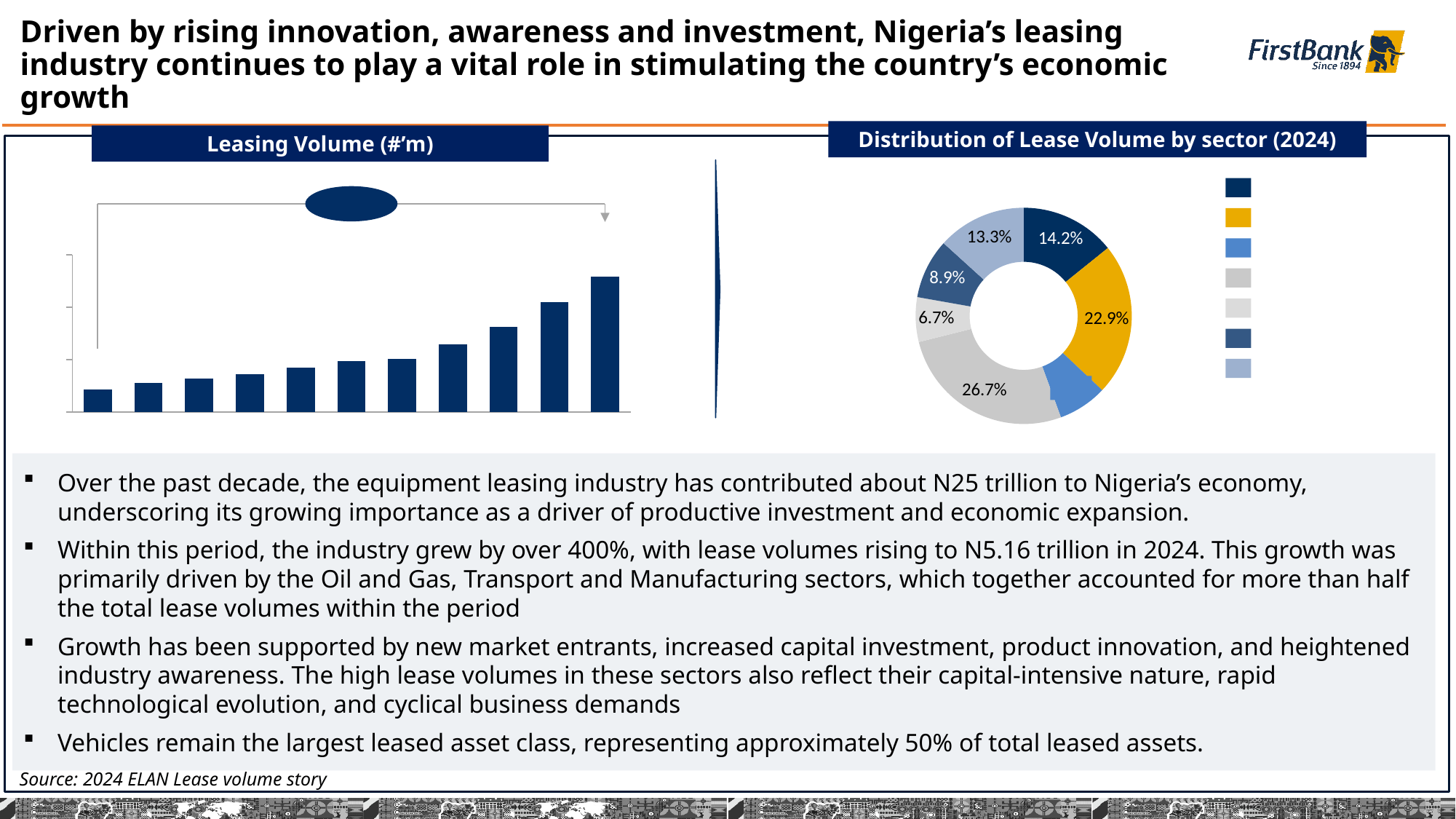
What kind of chart is the Distribution of Lease Volume by sector (2024) chart? doughnut (pie) chart In the Distribution of Lease Volume by sector (2024) chart, what is the difference between the largest slice (26.7%) and the yellow slice (22.9%)? 3.8 percentage points How many entries does the legend of the Distribution of Lease Volume by sector (2024) chart list? 7 In the Leasing Volume (#'m) chart, do the bars rise or fall from left to right? rise How many bars are plotted in the Leasing Volume (#'m) chart? 11 What is the title of the chart on the right of the slide? Distribution of Lease Volume by sector (2024) What kind of chart is the Leasing Volume (#'m) chart on the left? bar chart In the Distribution of Lease Volume by sector (2024) chart, what percentage is shown on the yellow slice? 22.9% How many slices does the Distribution of Lease Volume by sector (2024) chart have? 7 In the Distribution of Lease Volume by sector (2024) chart, which is larger: the slice labelled 13.3% or the slice labelled 8.9%? 13.3% In the Distribution of Lease Volume by sector (2024) chart, what is the largest labelled share? 26.7% In the Distribution of Lease Volume by sector (2024) chart, what percentage is shown on the dark navy slice at the top? 14.2%